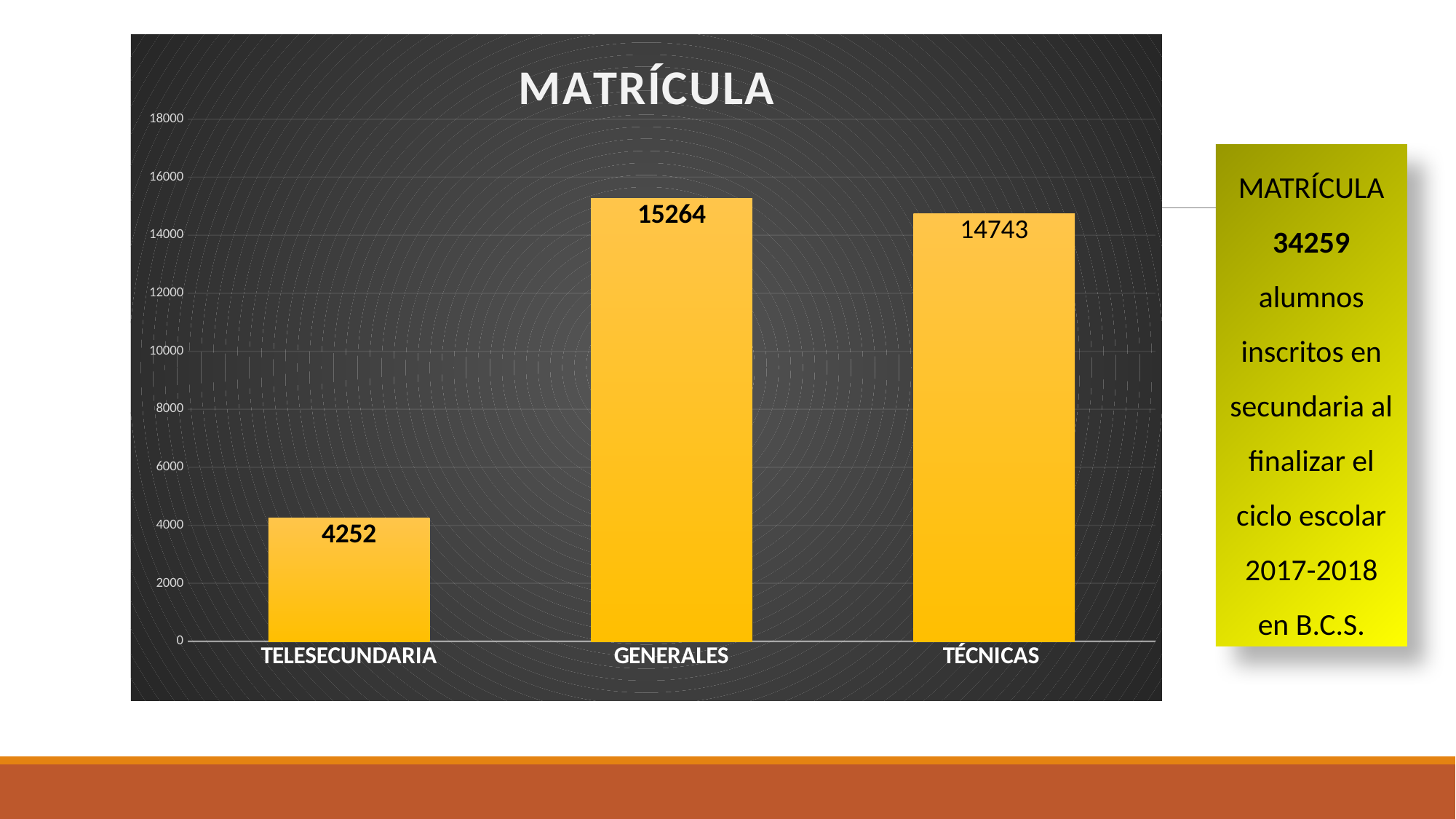
Is the value for TELESECUNDARIA greater or less than 6000? less What is the difference between the values for GENERALES and TÉCNICAS? 521 What is the value for TÉCNICAS? 14743 How many categories are shown in the chart? 3 What kind of chart is shown on the slide? bar chart Which category has the lowest value? TELESECUNDARIA What is the value for GENERALES? 15264 Which category has the highest value? GENERALES What is the value for TELESECUNDARIA? 4252 What is the title of the chart? MATRÍCULA What is the difference between the values for GENERALES and TELESECUNDARIA? 11012 Which is larger, the value for TÉCNICAS or the value for TELESECUNDARIA? TÉCNICAS